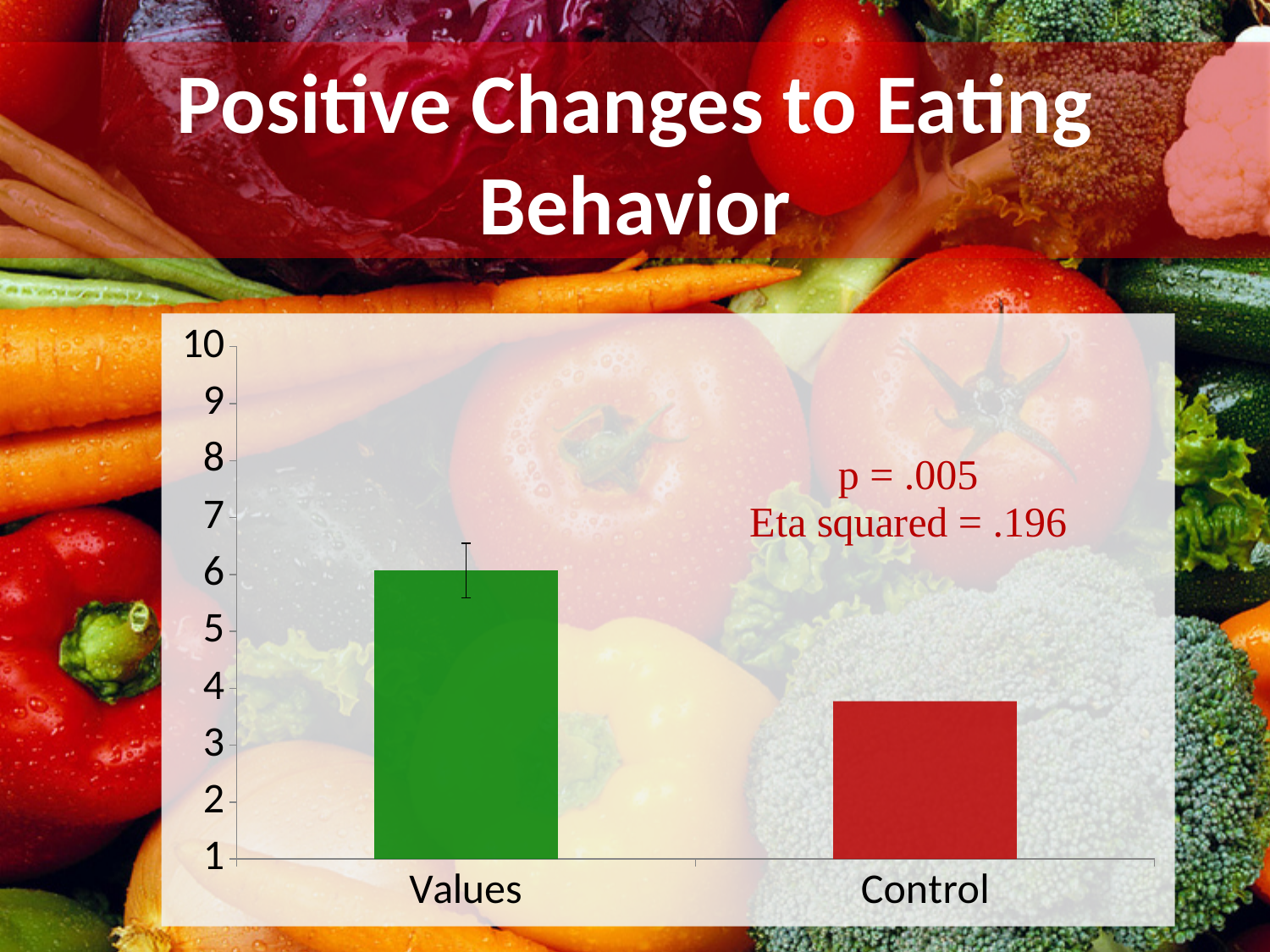
What kind of chart is shown on the slide? bar chart Is the value for Values greater or less than 7? less Which category has the lowest bar in the chart? Control Which bar is taller, Values or Control? Values Which category has the highest bar in the chart? Values What is the title of the slide containing the chart? Positive Changes to Eating Behavior How many categories are shown on the x axis of the chart? 2 Is the value for Control greater or less than 3? greater Is the value for Control greater or less than 4? less What p value is printed next to the chart? p = .005